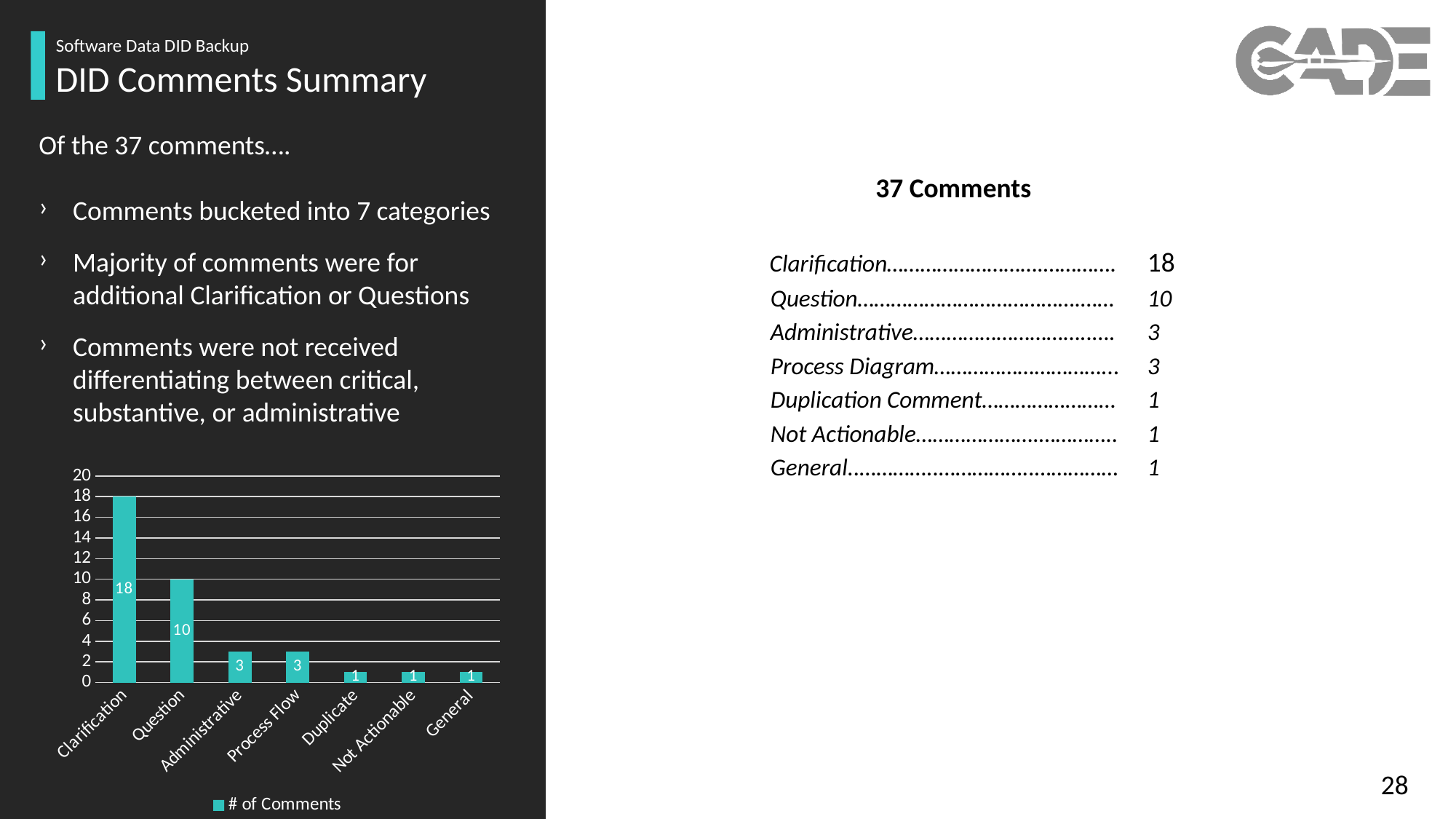
What is the value for Process Flow in the bar chart? 3 What is the value for Clarification in the bar chart? 18 Which is larger, the value for Administrative or the value for Duplicate? Administrative How many categories are shown on the x axis of the bar chart? 7 What is the value for Question in the bar chart? 10 Which category has the highest value in the bar chart? Clarification What kind of chart is shown on the slide? bar chart How many series does the legend of the chart list? 1 What is the legend entry for the series in the chart? # of Comments Do the values rise or fall moving from left to right along the x axis? fall What is the difference between the values for Clarification and Question? 8 Is the value for Question greater or less than 8? greater